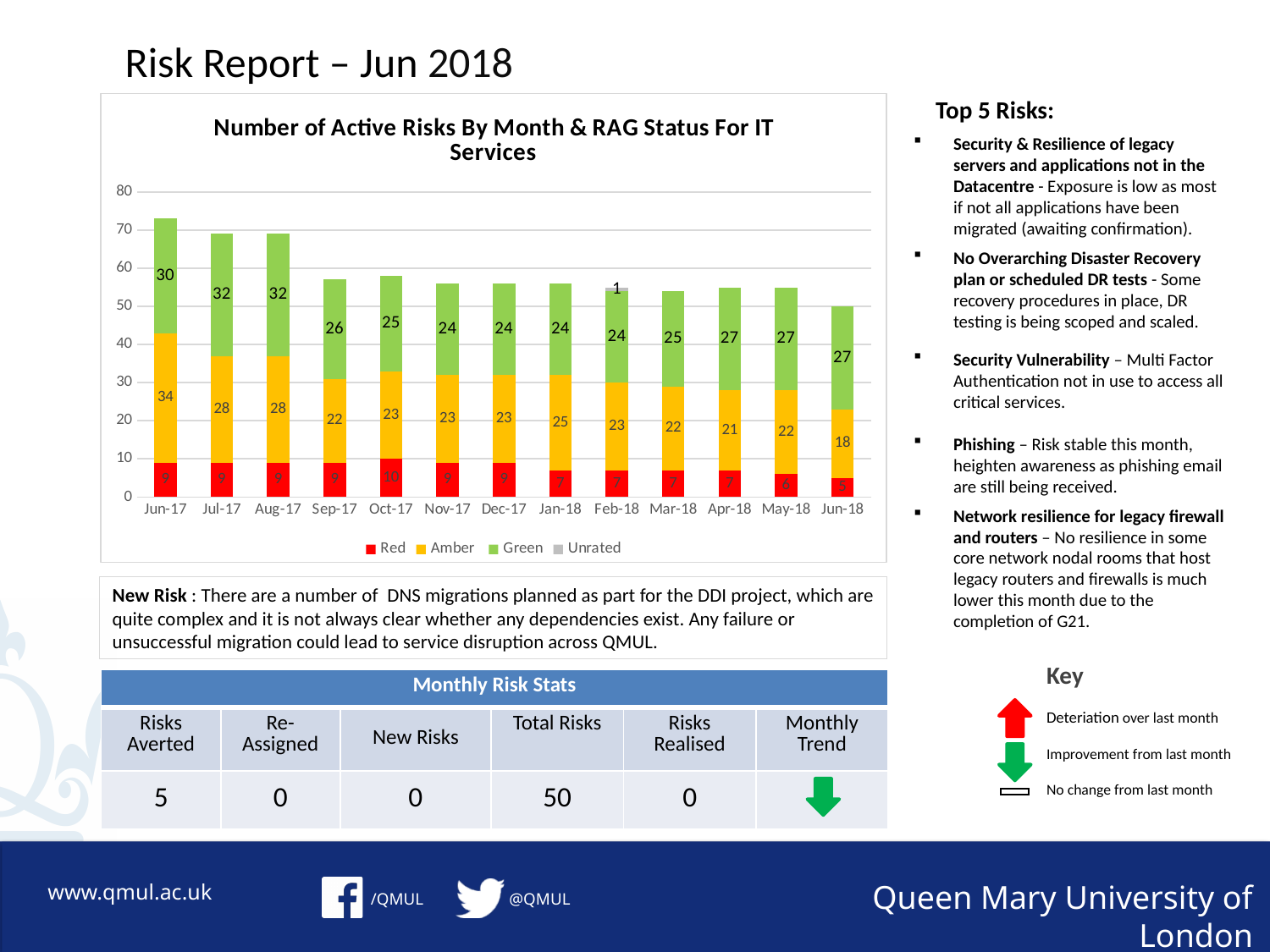
What is the Amber value for Jun-17? 34 What is the Red value for Oct-17? 10 What is the difference between the Amber values for Jun-17 and Jun-18? 16 Which month has the lowest Amber value? Jun-18 How many series does the chart legend list? 4 What is the Green value for Jun-18? 27 How many months are plotted on the x axis of the chart? 13 Which month has the highest Red value? Oct-17 What type of chart is shown on the slide? Stacked bar chart Is the total height of the Jun-17 bar greater or less than 70? greater What is the total number of active risks for Jun-18 (sum of the stacked bar)? 50 Which month shows a non-zero Unrated value? Feb-18